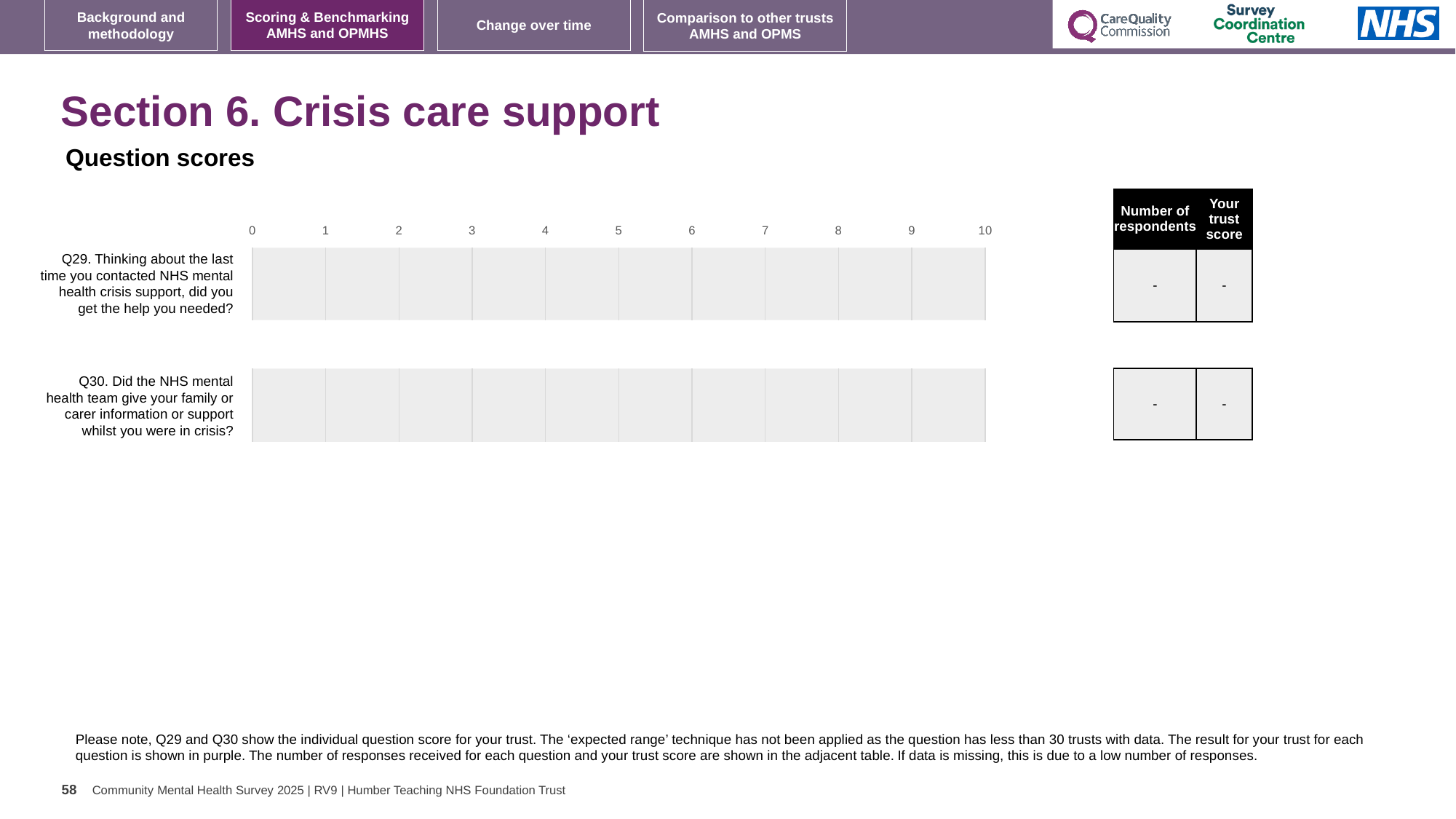
What is shown in the 'Your trust score' column for Q30 in the adjacent table? - What is the highest value shown on the horizontal axis of the Question scores chart? 10 What is shown in the 'Your trust score' column for Q29 in the adjacent table? - Which question number is listed first (at the top) on the Question scores chart? Q29 What is the lowest value shown on the horizontal axis of the Question scores chart? 0 What is shown in the 'Number of respondents' column for Q30 in the adjacent table? - What is shown in the 'Number of respondents' column for Q29 in the adjacent table? - How many questions (categories) are listed on the Question scores chart? 2